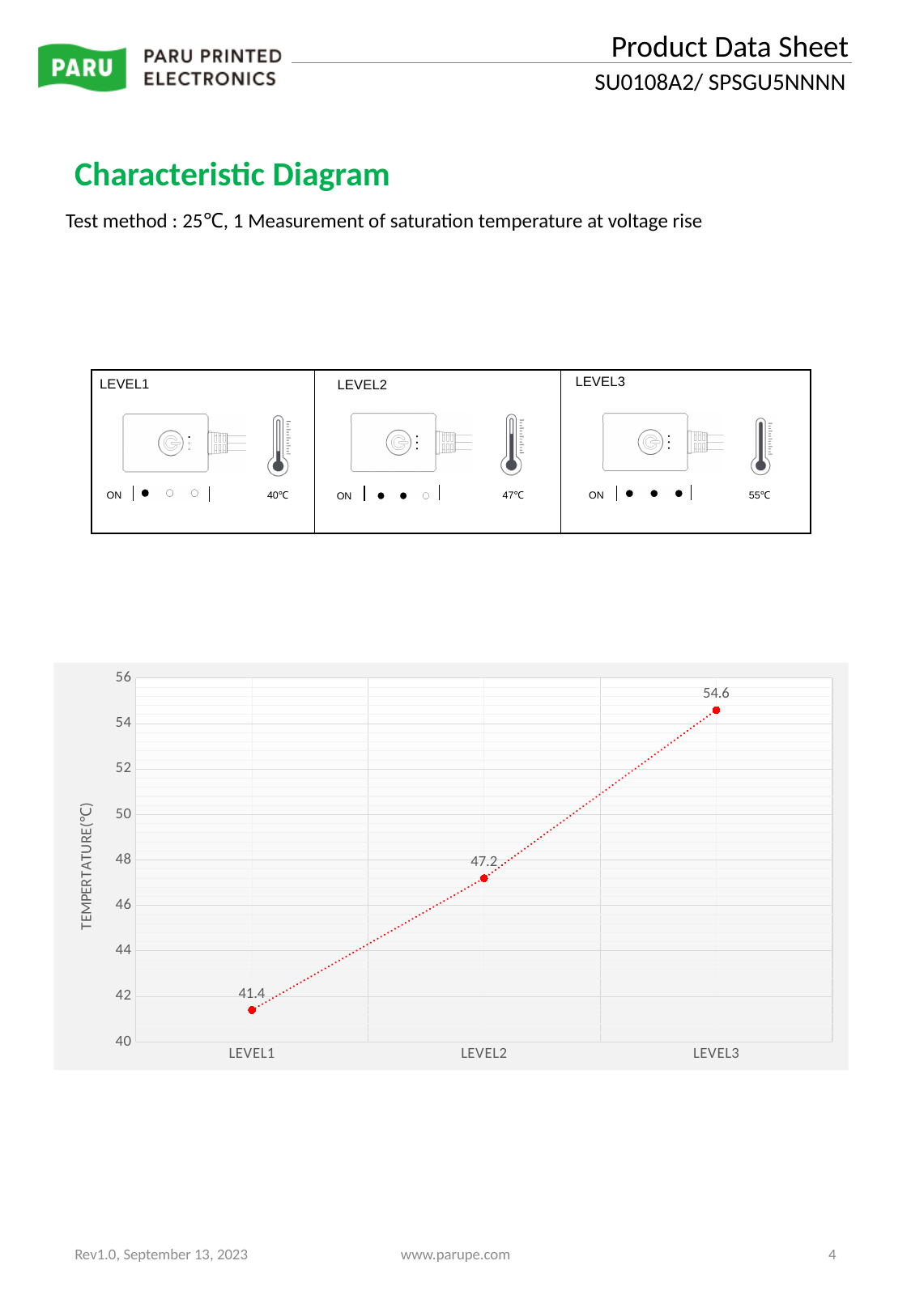
Which level has the highest plotted temperature? LEVEL3 Which level has the lowest plotted temperature? LEVEL1 Is the plotted value for LEVEL2 greater or less than 48? less What is the difference between the plotted temperatures for LEVEL3 and LEVEL1? 13.2 What is the difference between the plotted temperatures for LEVEL2 and LEVEL1? 5.8 How many data points are plotted on the chart? 3 What kind of chart is shown on the slide? line chart Do the plotted values rise or fall from LEVEL1 to LEVEL3? rise Which has a larger plotted temperature, LEVEL2 or LEVEL3? LEVEL3 What is the temperature value plotted for LEVEL2? 47.2 What is the temperature value plotted for LEVEL1? 41.4 What is the temperature value plotted for LEVEL3? 54.6